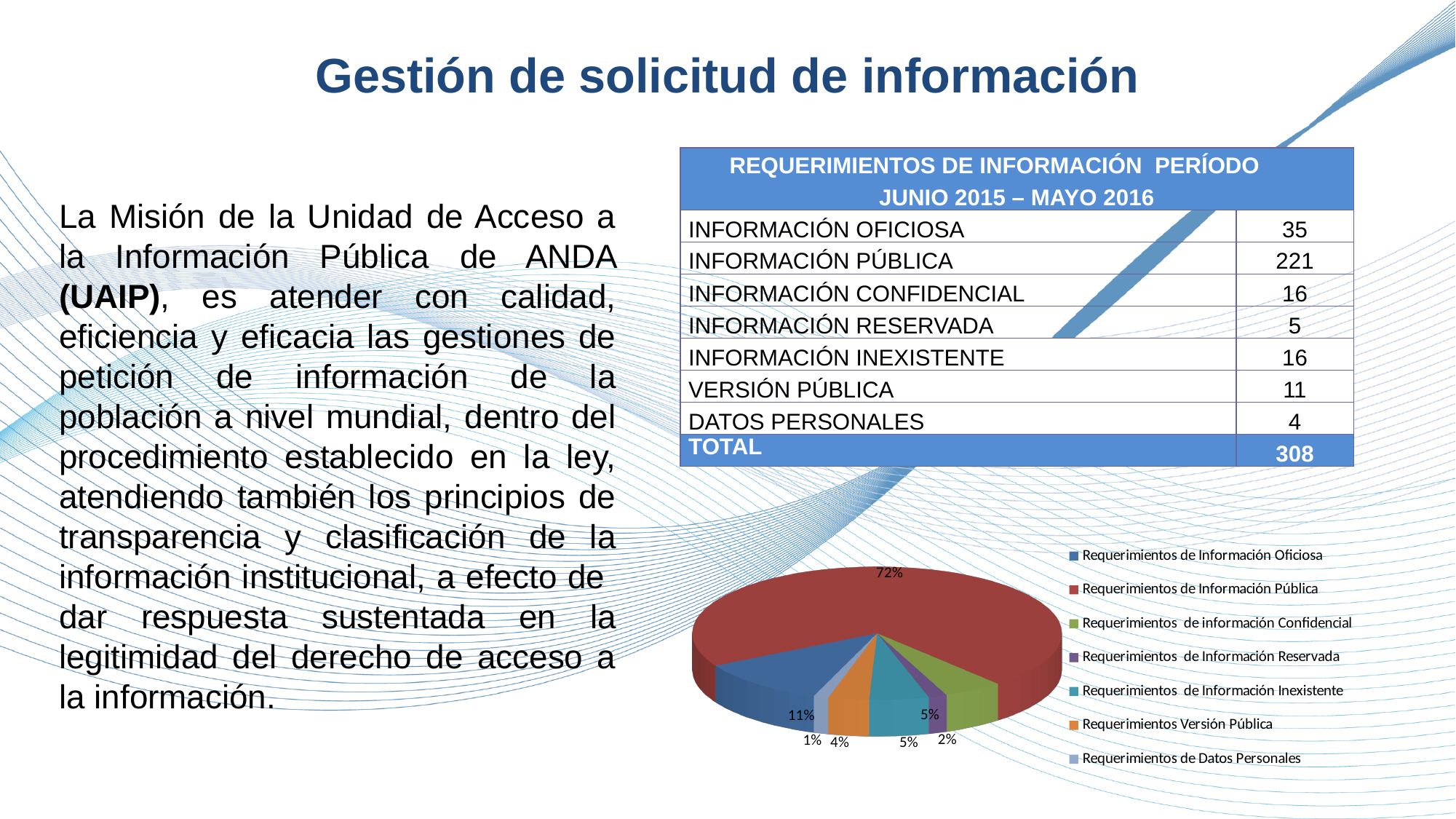
What percentage does the pie chart show for Requerimientos Versión Pública? 4% What percentage is shown for the largest slice of the pie chart? 72% Which category has the largest slice of the pie chart? Requerimientos de Información Pública What percentage does the pie chart show for Requerimientos de Datos Personales? 1% By how many percentage points does the Información Pública slice exceed the Información Oficiosa slice? 61 Which slice is larger in the pie chart: Requerimientos de Información Oficiosa or Requerimientos Versión Pública? Requerimientos de Información Oficiosa What percentage does the pie chart show for Requerimientos de Información Oficiosa? 11% How many entries does the pie chart's legend list? 7 What percentage does the pie chart show for Requerimientos de Información Reservada? 2% What colour is the slice for Requerimientos de Información Pública in the pie chart? Red What kind of chart is shown on the slide? Pie chart Which category has the smallest slice of the pie chart? Requerimientos de Datos Personales